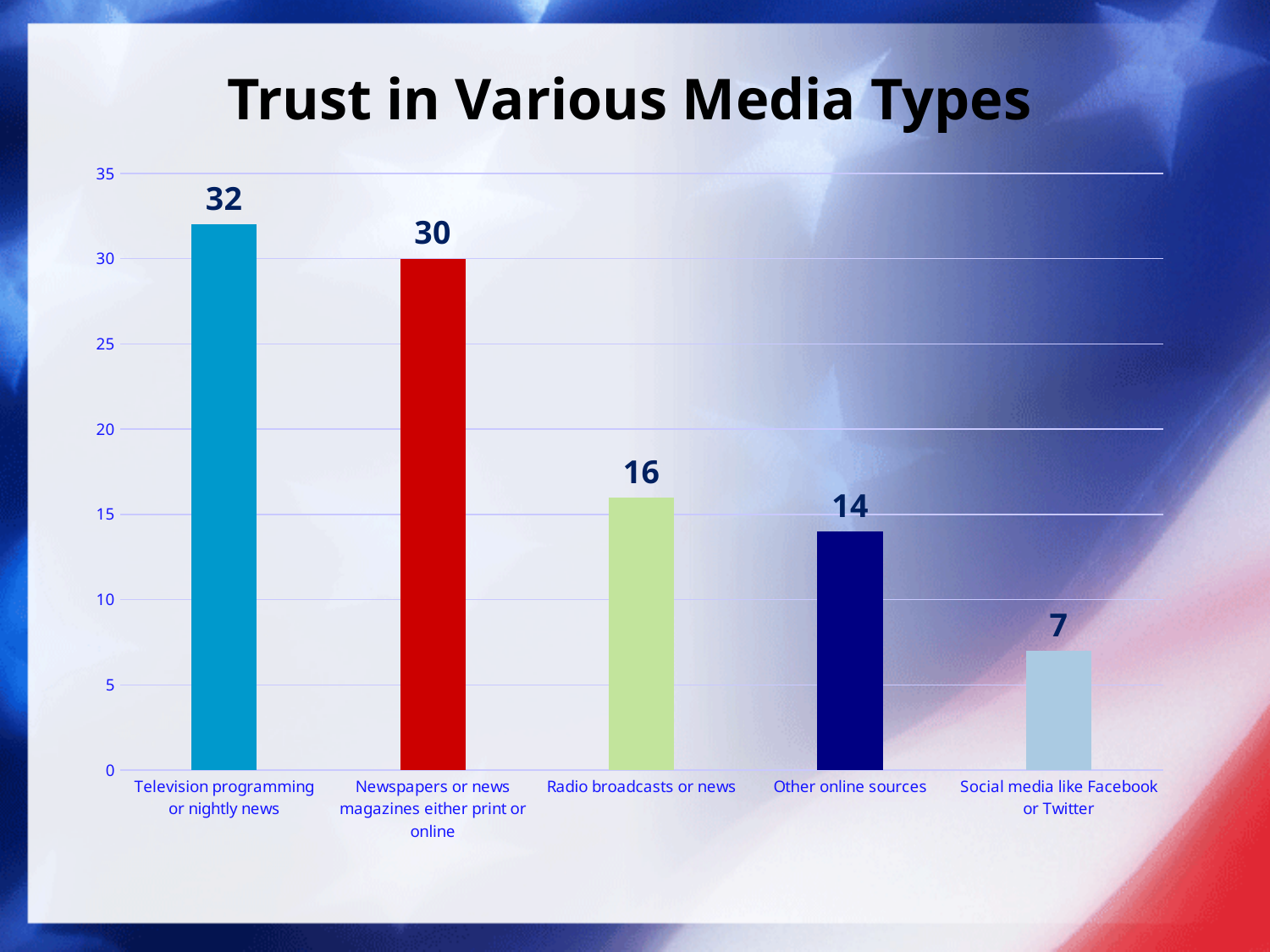
What is the title of the chart? Trust in Various Media Types Is the value for Other online sources greater or less than 15? less Which is larger, the value for Radio broadcasts or news or the value for Other online sources? Radio broadcasts or news How many media types are shown in the chart? 5 Which media type has the highest value? Television programming or nightly news What is the difference between the values for Television programming or nightly news and Social media like Facebook or Twitter? 25 What is the value for Social media like Facebook or Twitter? 7 Which media type has the lowest value? Social media like Facebook or Twitter What kind of chart is shown on the slide? Bar chart What is the value for Radio broadcasts or news? 16 What is the value for Television programming or nightly news? 32 What is the value for Newspapers or news magazines either print or online? 30